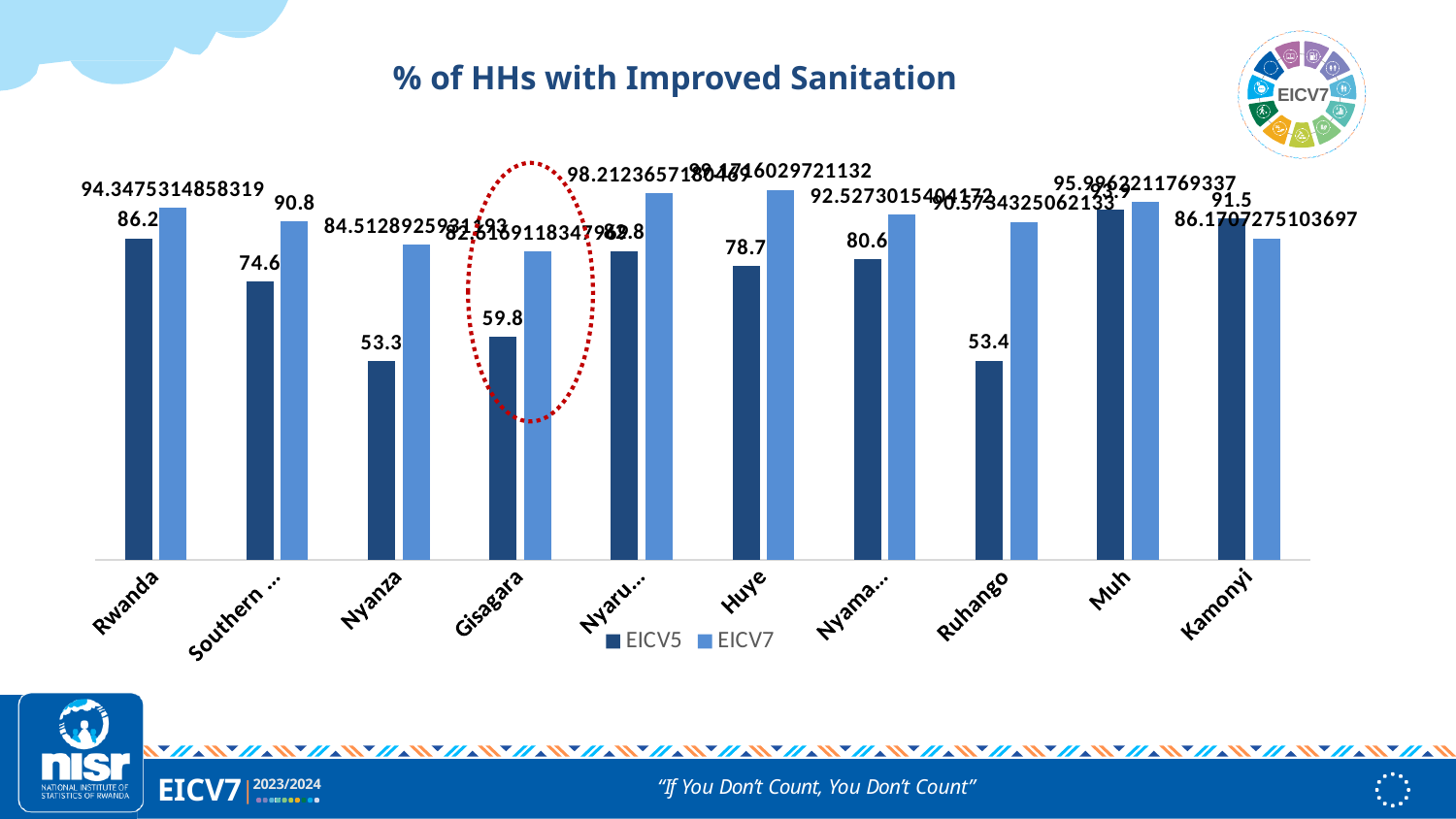
What is the EICV5 value for Rwanda? 86.2 What kind of chart is shown on the slide? bar chart What is the title of the chart? % of HHs with Improved Sanitation For Rwanda, which series has the larger value, EICV5 or EICV7? EICV7 What is the EICV7 value for Southern ...? 90.8 What is the EICV5 value for Gisagara? 59.8 What is the EICV5 value for Nyanza? 53.3 Which has the larger EICV5 value, Gisagara or Huye? Huye How many series does the legend list? 2 How many categories are shown on the x axis? 10 What is the EICV5 value for Kamonyi? 91.5 What is the difference between the EICV5 values for Rwanda and Southern ...? 11.6